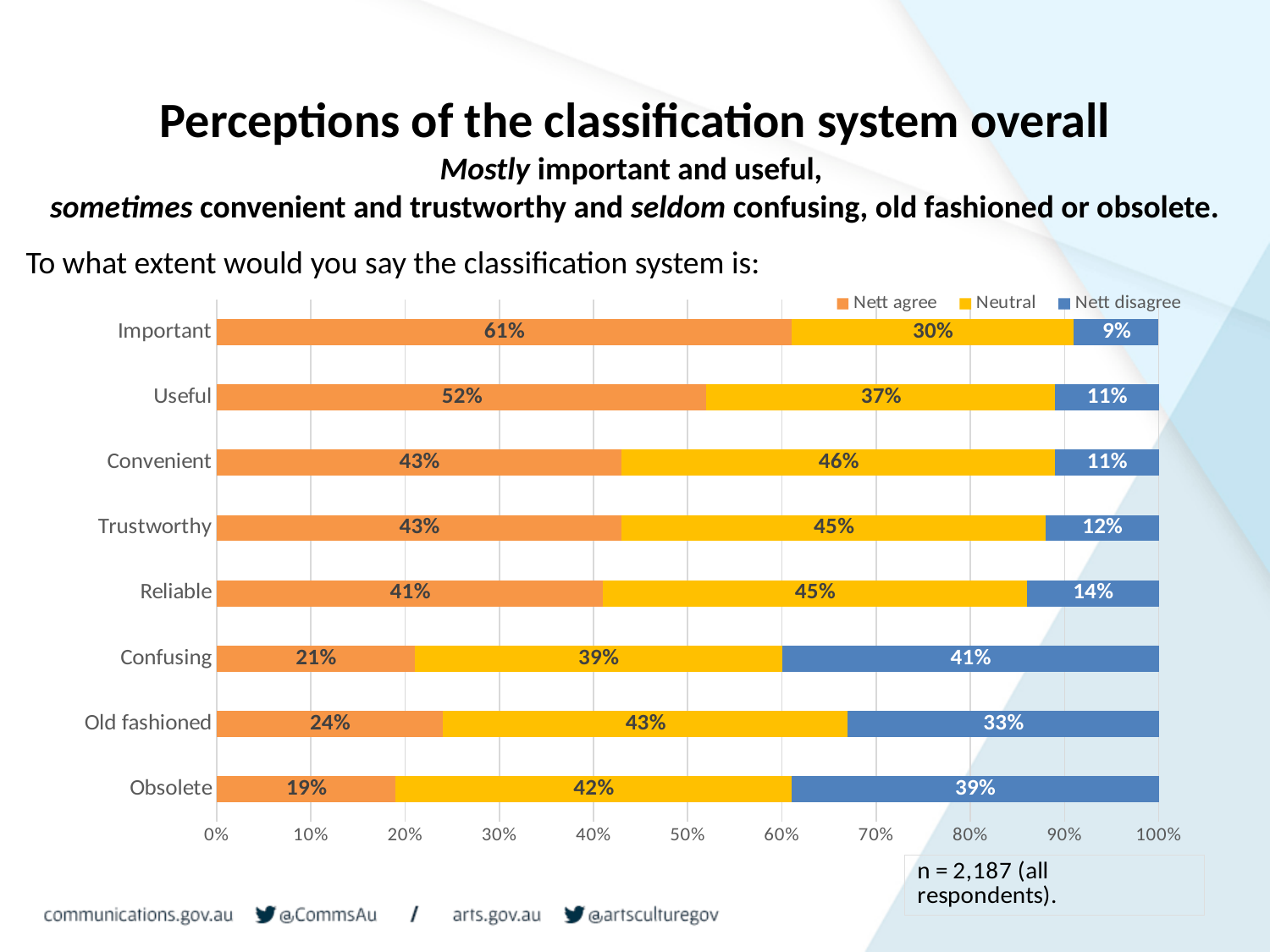
What is the Nett disagree value for Obsolete? 39% Which category has the highest Nett agree value? Important Which is larger, the Nett disagree value for Confusing or for Old fashioned? Confusing How many categories are shown on the chart? 8 What is the Nett agree value for Important? 61% What is the Neutral value for Convenient? 46% How many series does the legend list? 3 What is the total of the Reliable bar? 100% Which category has the lowest Nett disagree value? Important What colour represents the Neutral series? Yellow What is the difference between the Nett agree values for Important and Useful? 9% What kind of chart is shown on the slide? Stacked bar chart